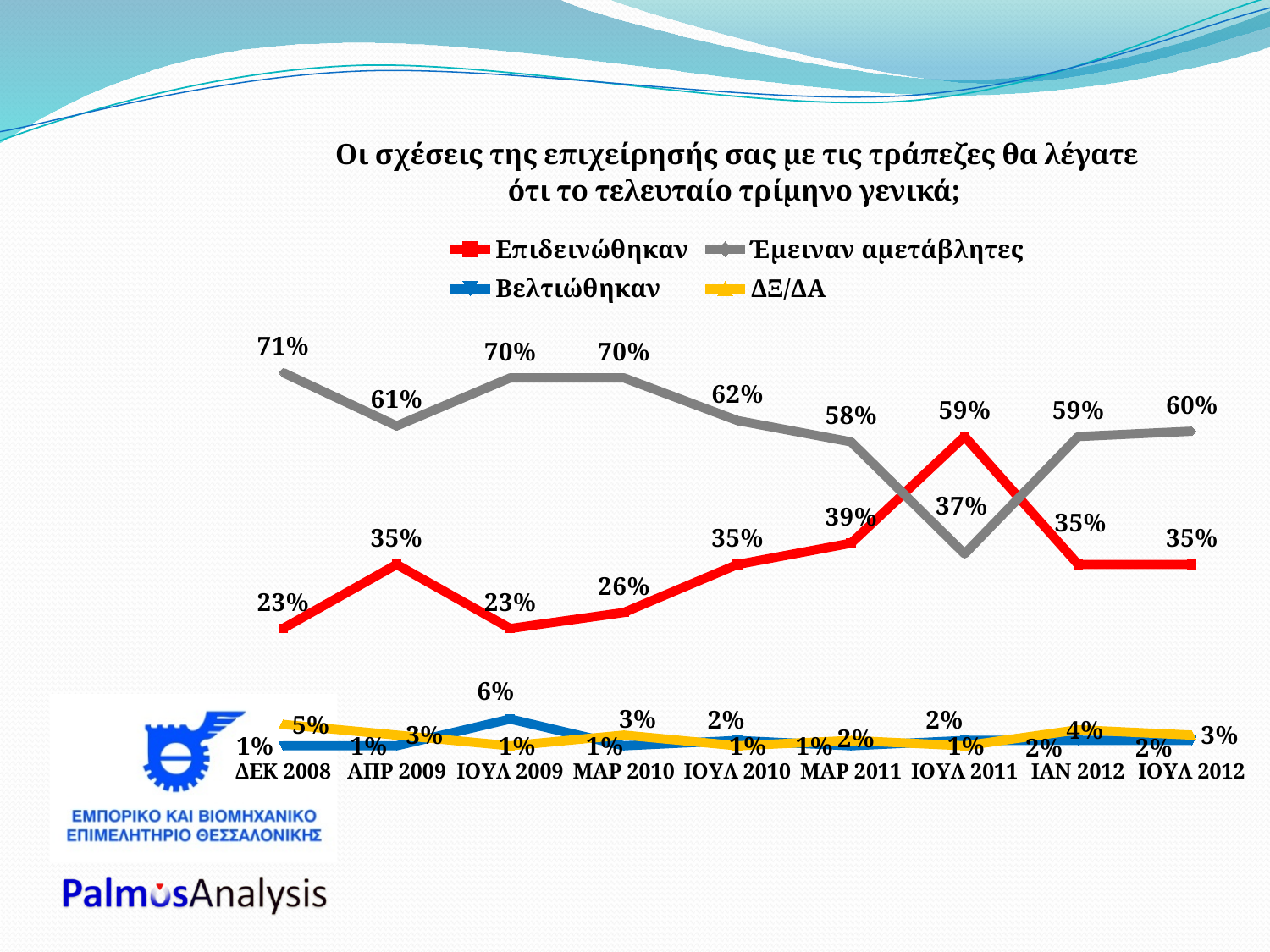
What is the value of the 'Επιδεινώθηκαν' series at ΜΑΡ 2010? 26% At ΙΟΥΛ 2011, which is larger: 'Επιδεινώθηκαν' or 'Έμειναν αμετάβλητες'? Επιδεινώθηκαν At which time point does the 'Επιδεινώθηκαν' series reach its peak? ΙΟΥΛ 2011 How many series does the legend list? 4 What is the difference between 'Έμειναν αμετάβλητες' and 'Επιδεινώθηκαν' at ΔΕΚ 2008? 48 percentage points What is the value of the 'Βελτιώθηκαν' series at ΙΟΥΛ 2009? 6% How many time points are shown along the x axis? 9 What is the value of the 'Επιδεινώθηκαν' series at ΙΟΥΛ 2011? 59% What type of chart is shown on the slide? Line chart At which time point is the 'Έμειναν αμετάβλητες' series lowest? ΙΟΥΛ 2011 What is the value of the 'Έμειναν αμετάβλητες' series at ΔΕΚ 2008? 71% At which time point is the 'Έμειναν αμετάβλητες' series highest? ΔΕΚ 2008